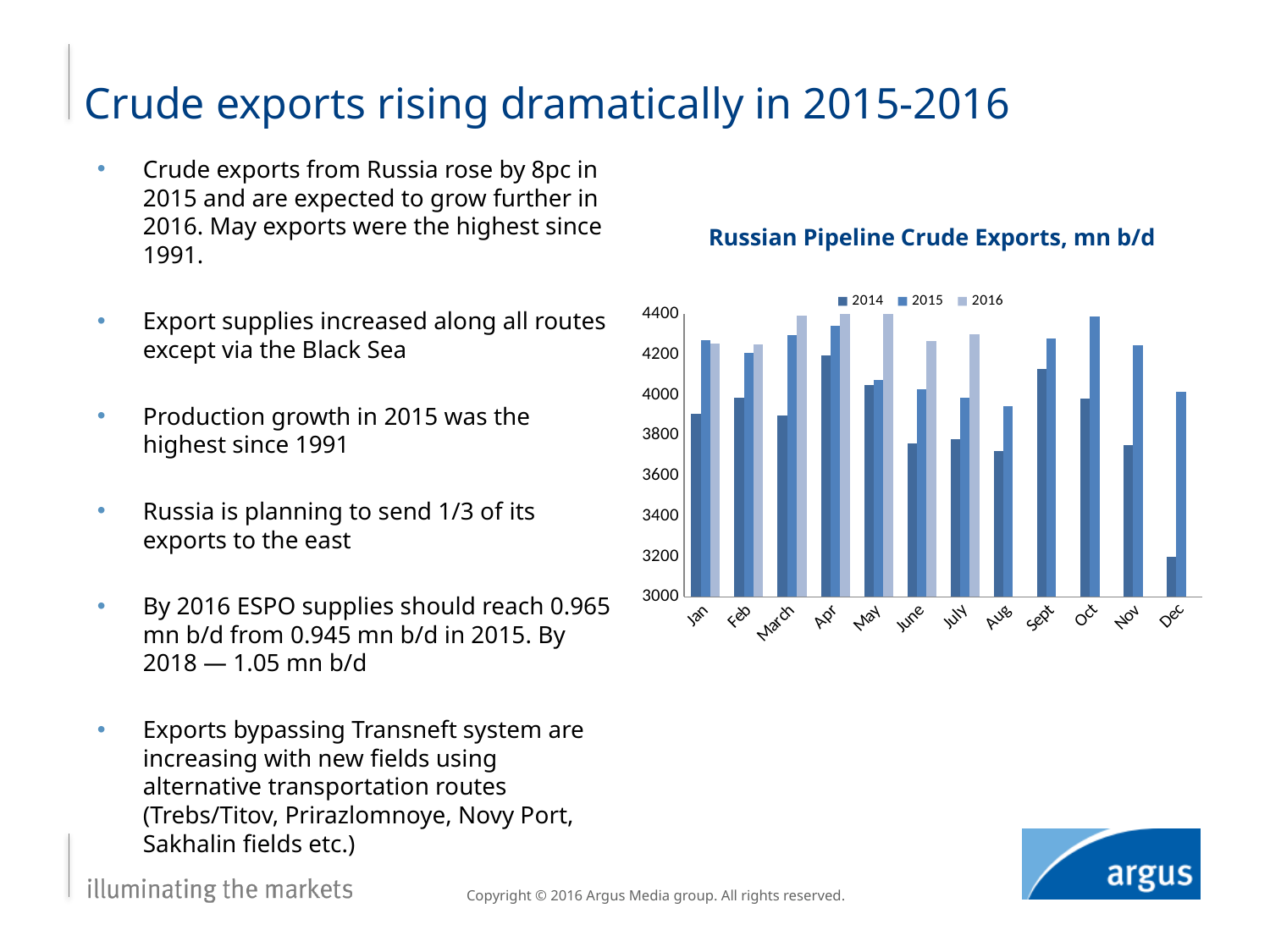
Is the 2014 value for Dec greater or less than 3400? less Which years are listed in the chart's legend? 2014, 2015, 2016 Is the 2014 value for Aug greater or less than 3800? less How many series does the legend of the chart list? 3 What is the title of the chart? Russian Pipeline Crude Exports, mn b/d In which month is the 2014 bar the lowest? Dec For how many months does the chart show a 2016 bar? 7 Is the 2016 value for May greater or less than 4200? greater What kind of chart is shown on the slide? bar chart How many months are shown on the x axis of the chart? 12 For Dec, which is larger: the 2014 value or the 2015 value? 2015